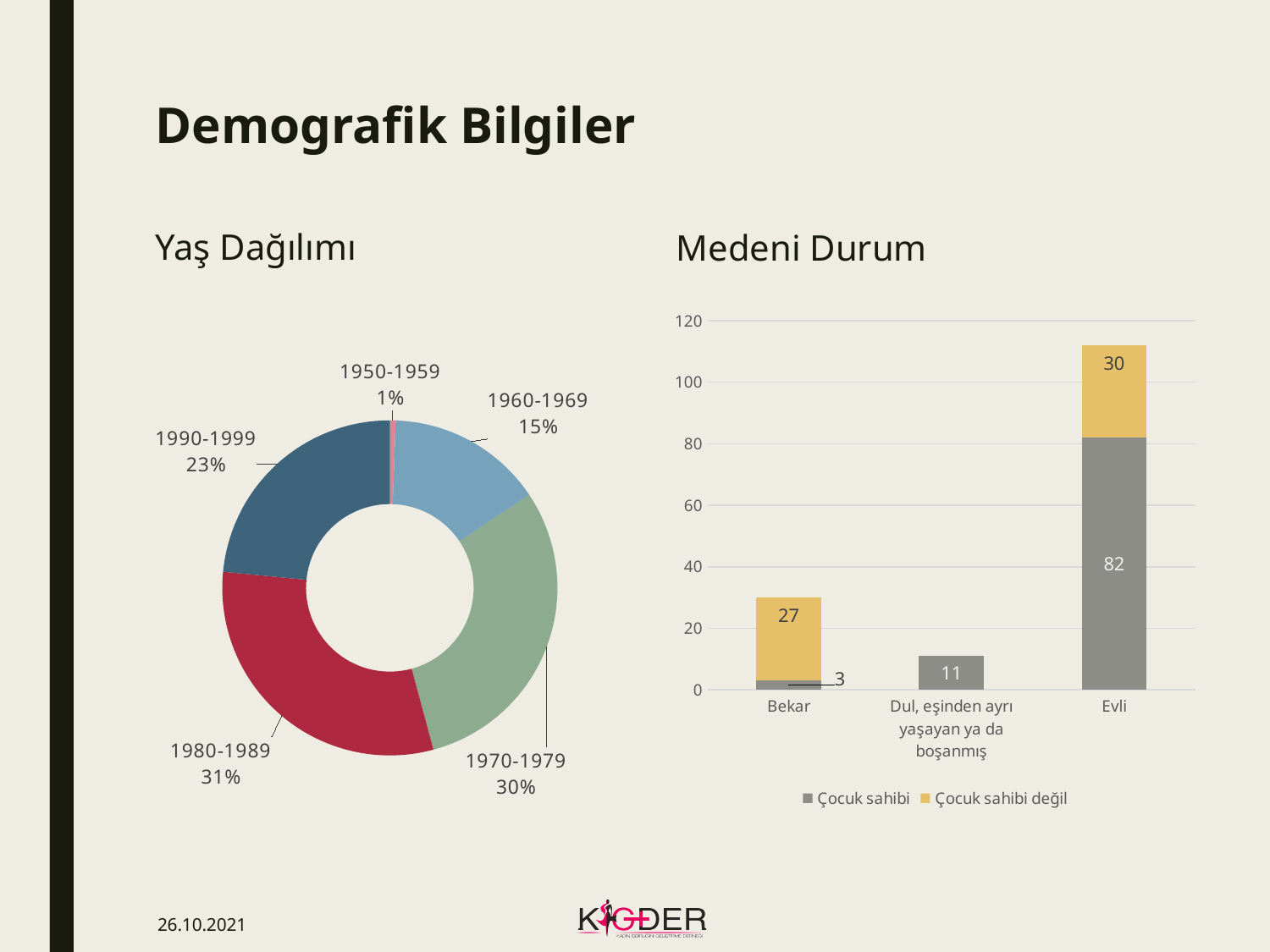
How many series does the legend of the Medeni Durum chart list? 2 In the Yaş Dağılımı chart, what is the difference between the shares of 1990-1999 and 1960-1969? 8% In the Medeni Durum chart, what is the total of the Evli bar? 112 In the Yaş Dağılımı chart, what share does the 1960-1969 group have? 15% In the Medeni Durum chart, which category has the tallest bar? Evli What kind of chart is the Yaş Dağılımı chart? Donut chart In the Medeni Durum chart, is the Çocuk sahibi value for Bekar larger or smaller than the Çocuk sahibi value for Dul, eşinden ayrı yaşayan ya da boşanmış? Smaller In the Yaş Dağılımı chart, what share does the 1980-1989 group have? 31% In the Medeni Durum chart, what is the Çocuk sahibi değil value for Bekar? 27 In the Medeni Durum chart, what is the Çocuk sahibi value for Evli? 82 In the Yaş Dağılımı chart, how many age groups are shown? 5 In the Yaş Dağılımı chart, which age group has the smallest share? 1950-1959